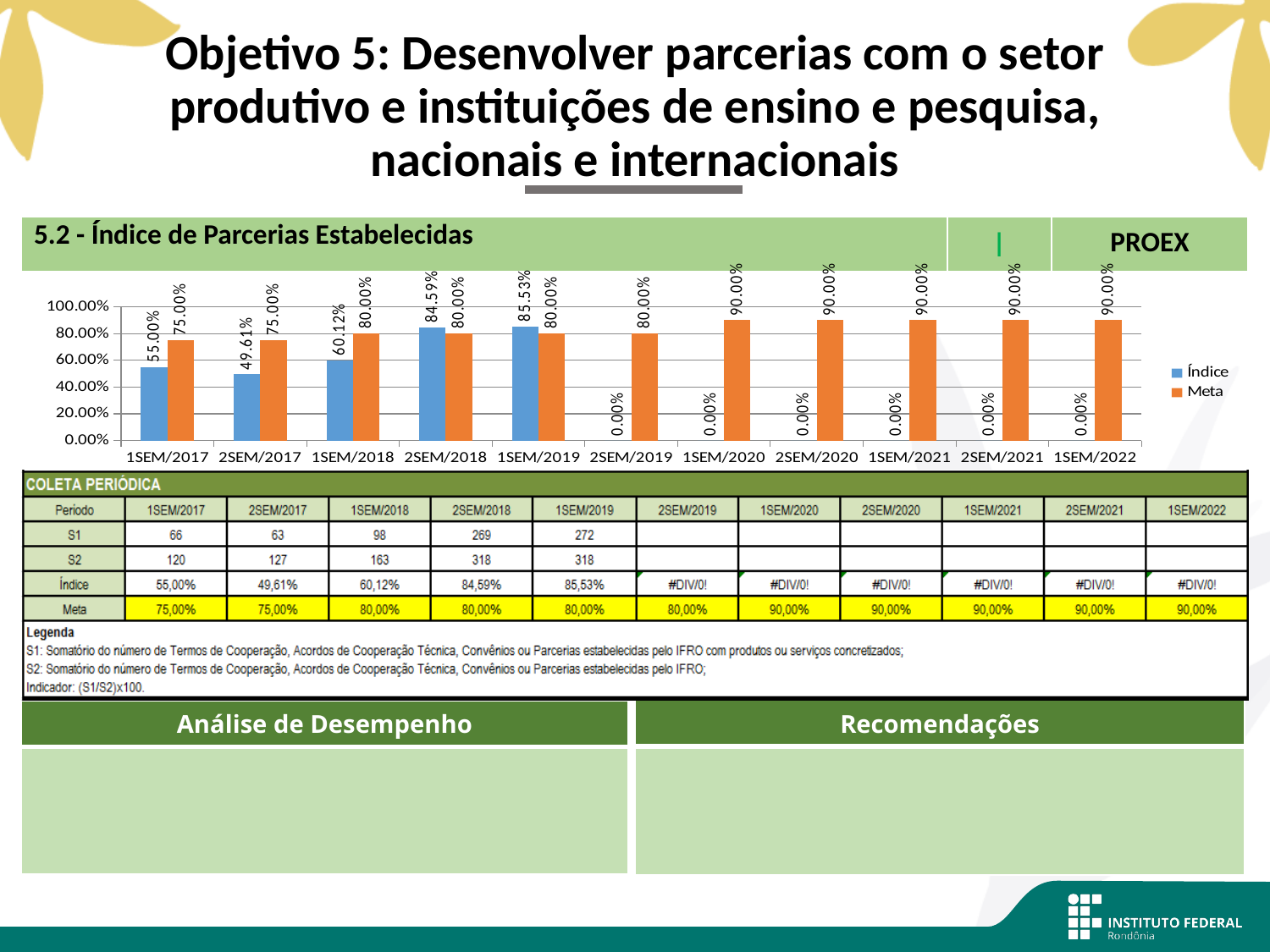
Among the periods with a non-zero Índice, which has the lowest Índice value? 2SEM/2017 Does the Meta series rise or fall from 1SEM/2017 to 1SEM/2022? rise What kind of chart is shown on the slide? bar chart What is the value of Meta for 1SEM/2022? 90.00% Which period has the highest Índice value? 1SEM/2019 How many periods are shown on the x axis of the chart? 11 What is the value of Índice for 1SEM/2017? 55.00% What is the value of Índice for 2SEM/2018? 84.59% Which is larger for 1SEM/2019, Índice or Meta? Índice How many series does the chart legend list? 2 Is the Índice value for 2SEM/2017 greater or less than 60.00%? less What is the difference between Meta and Índice for 1SEM/2018? 19.88%